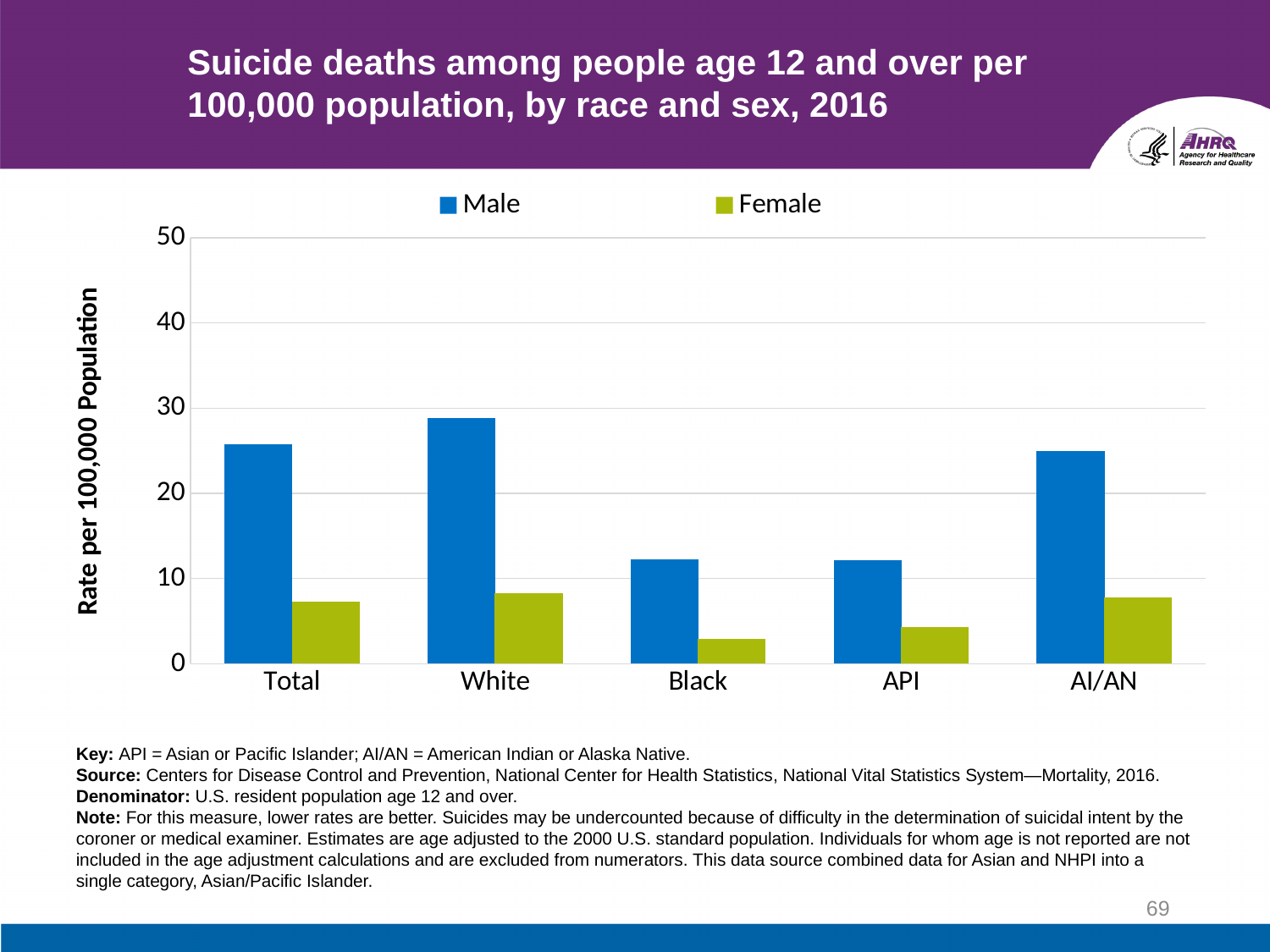
Is the Male value for White greater or less than 20? greater Is the Male value for Black greater or less than 20? less How many race categories are shown on the x axis? 5 Which category has the lowest Female suicide death rate? Black Which category has the highest Male suicide death rate? White Is the Male value for AI/AN greater or less than 20? greater Which is larger, the Male value for White or the Male value for Black? White What is the label of the y axis? Rate per 100,000 Population What kind of chart is shown on the slide? bar chart Which is larger, the Female value for Total or the Female value for Black? Total How many series does the legend list? 2